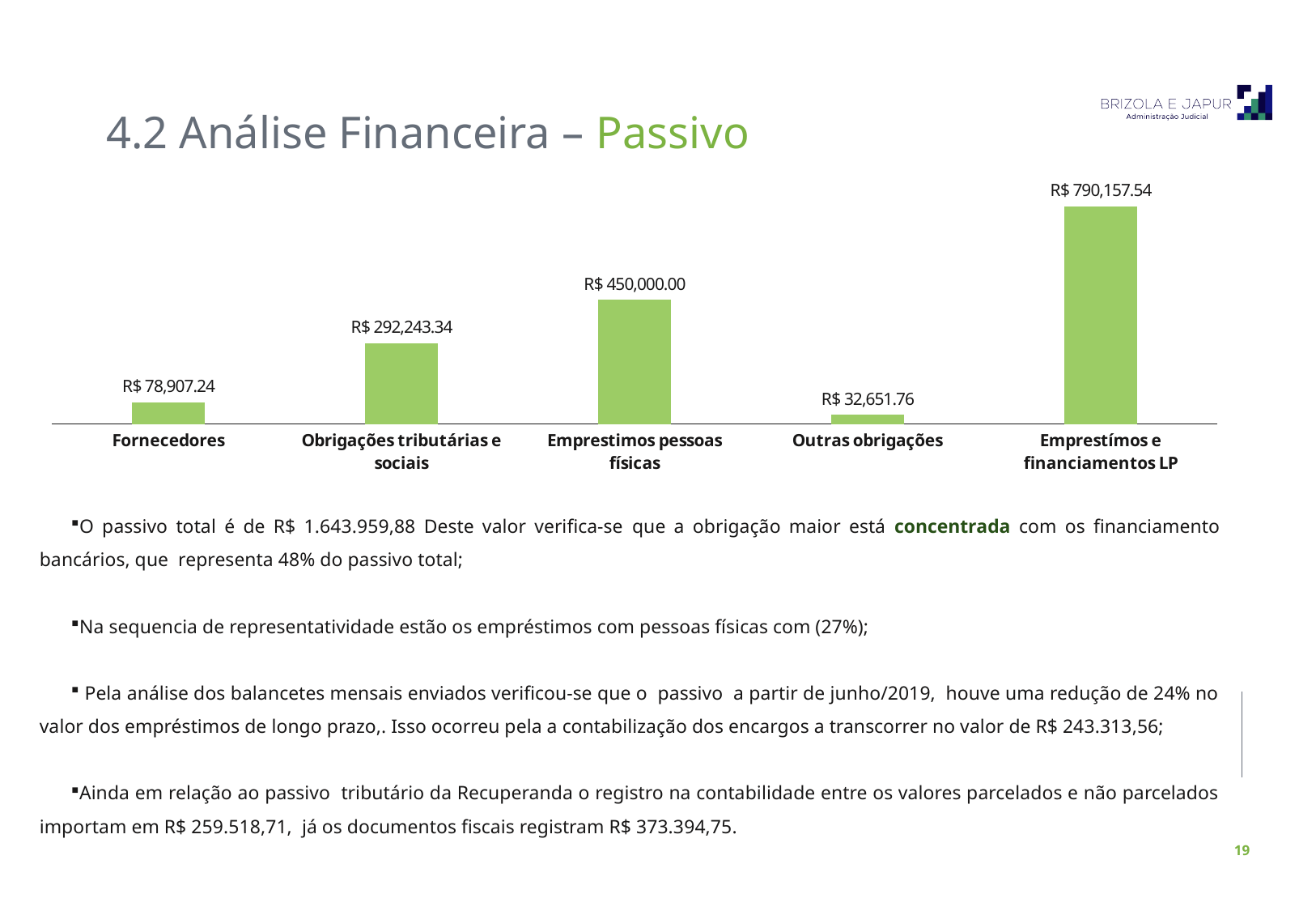
Which category has the lowest value? Outras obrigações What kind of chart is shown on the slide? Bar chart Which is larger, Obrigações tributárias e sociais or Emprestimos pessoas físicas? Emprestimos pessoas físicas How many categories are shown in the chart? 5 Which category has the highest value? Emprestímos e financiamentos LP What is the value for Outras obrigações? R$ 32,651.76 What is the value for Obrigações tributárias e sociais? R$ 292,243.34 What is the value for Fornecedores? R$ 78,907.24 What is the difference between Fornecedores and Outras obrigações? R$ 46,255.48 What is the value for Emprestimos pessoas físicas? R$ 450,000.00 What is the value for Emprestímos e financiamentos LP? R$ 790,157.54 What is the difference between Emprestímos e financiamentos LP and Emprestimos pessoas físicas? R$ 340,157.54